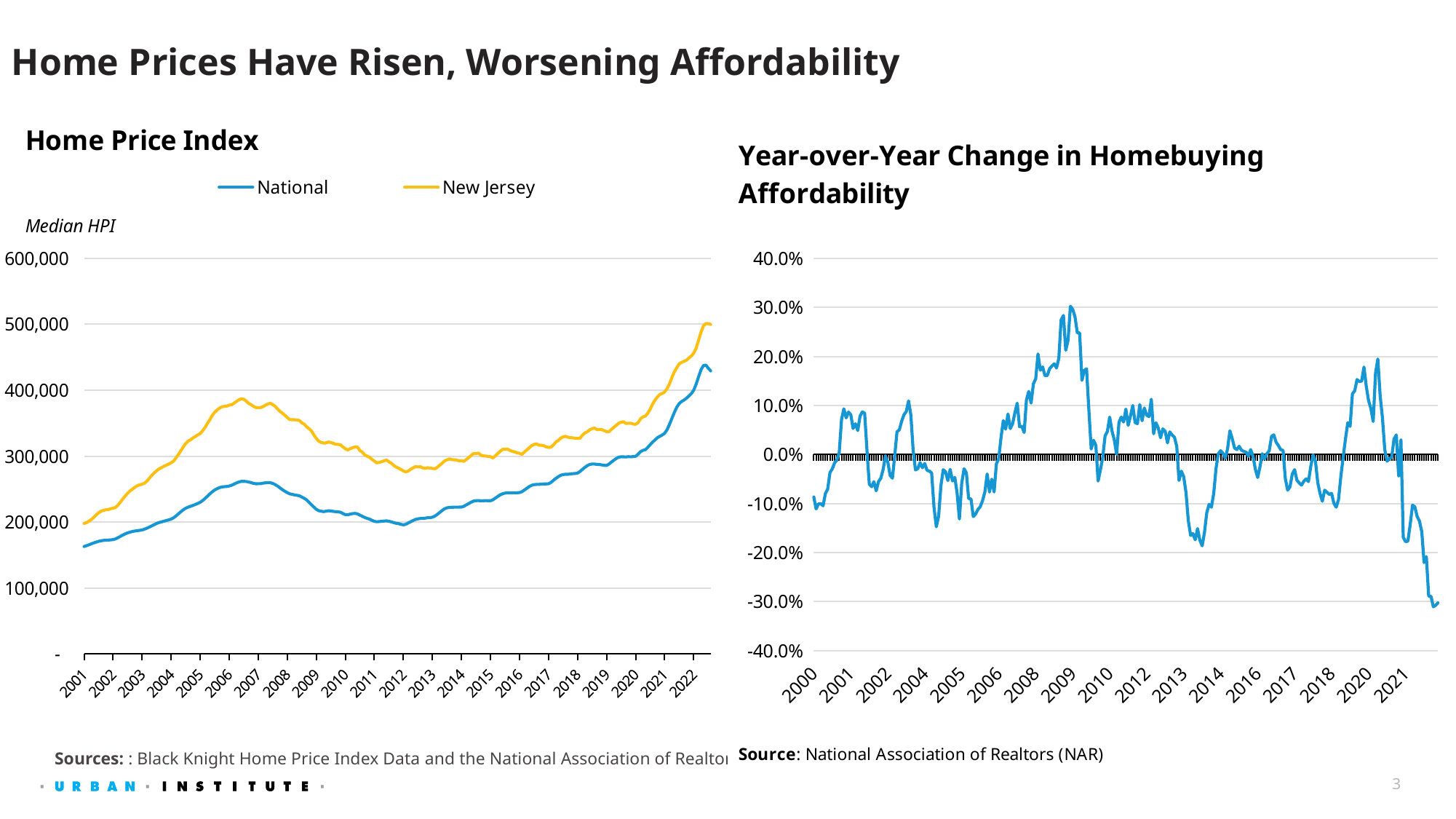
In the Home Price Index chart, is the National value in 2001 greater or less than 200,000? less In the Home Price Index chart, which series is higher throughout the period, National or New Jersey? New Jersey What is the y-axis label of the Home Price Index chart? Median HPI In the Home Price Index chart, is the National peak around 2006 greater or less than 300,000? less In the Home Price Index chart, is the National value in 2022 greater or less than 400,000? greater How many series does the legend of the Home Price Index chart list? 2 What kind of chart is the Year-over-Year Change in Homebuying Affordability chart on the right? line chart In the Home Price Index chart, does the New Jersey series rise or fall between 2012 and 2022? rise What kind of chart is the Home Price Index chart on the left? line chart